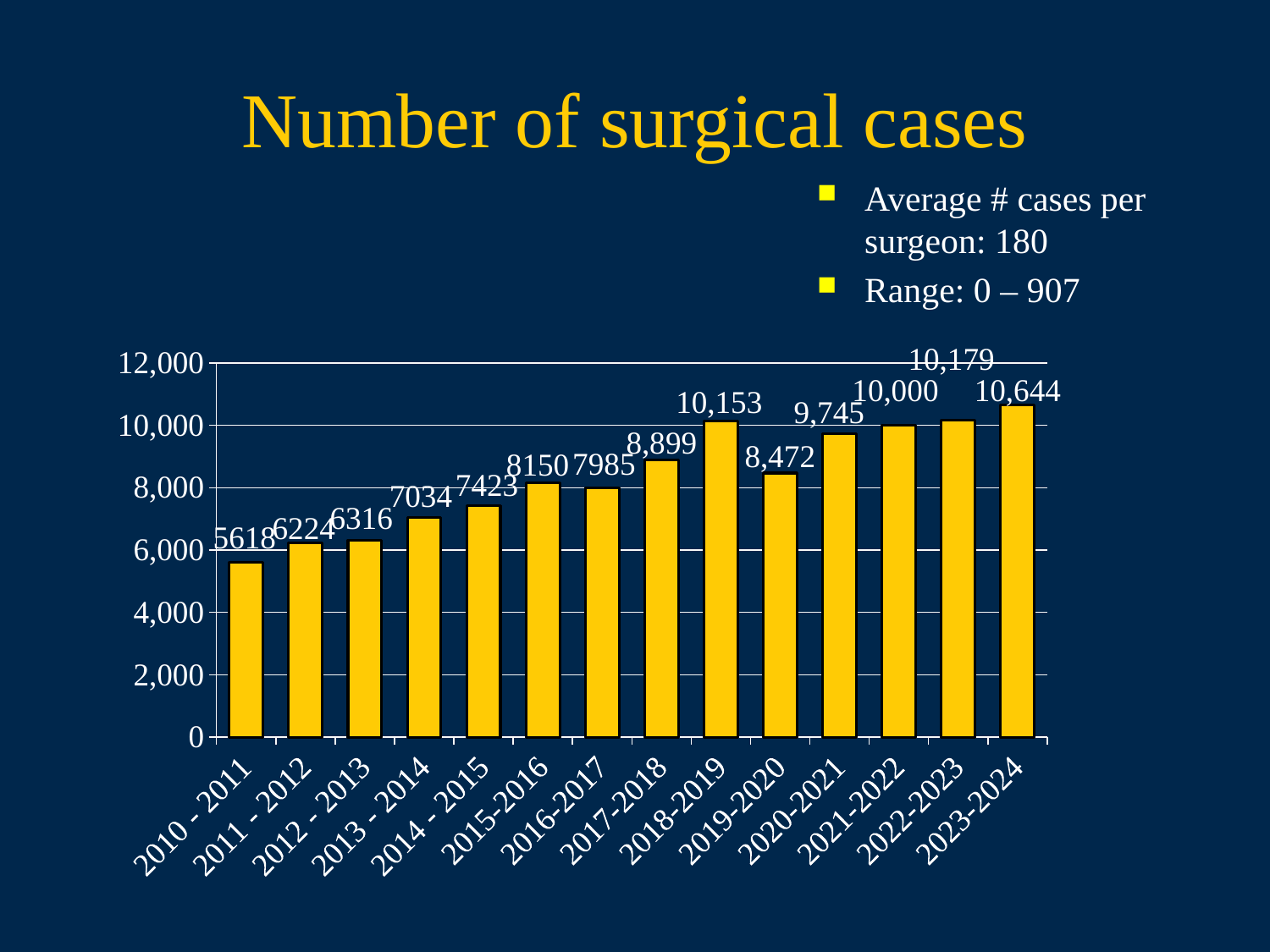
What kind of chart is shown on the slide? bar chart What is the difference in surgical cases between 2023-2024 and 2010 - 2011? 5026 Which year had more surgical cases, 2015-2016 or 2016-2017? 2015-2016 Which year has the lowest number of surgical cases? 2010 - 2011 What is the title of the chart? Number of surgical cases What is the difference in surgical cases between 2018-2019 and 2019-2020? 1681 Which year has the highest number of surgical cases? 2023-2024 What is the number of surgical cases for 2018-2019? 10,153 What is the number of surgical cases for 2010 - 2011? 5618 What is the number of surgical cases for 2021-2022? 10,000 How many years are shown on the chart? 14 Is the number of surgical cases for 2019-2020 greater or less than 10,000? less